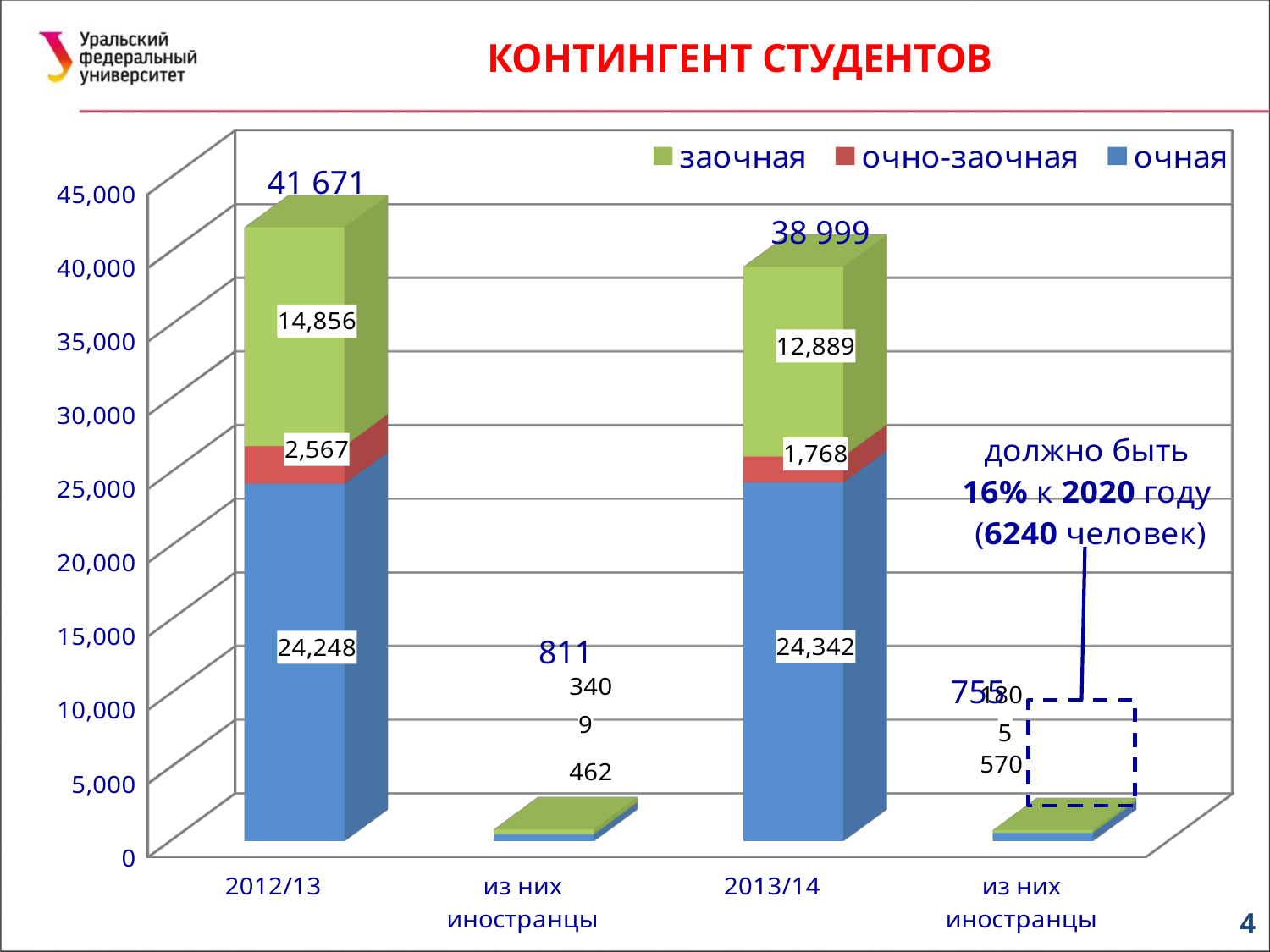
What is the difference between the заочная values for 2012/13 and 2013/14? 1,967 Which is larger, the очная value for 2012/13 or for 2013/14? 2013/14 What is the total shown above the 2013/14 bar? 38 999 How many categories are shown on the x axis? 4 What is the value of the очно-заочная series for 2012/13? 2,567 What is the value of the заочная series for 2013/14? 12,889 What is the title of the chart? КОНТИНГЕНТ СТУДЕНТОВ Which series has the lowest value in the 2013/14 bar? очно-заочная What is the total shown for the foreign students (из них иностранцы) in 2012/13? 811 How many series does the legend list? 3 What is the value of the очная series for 2012/13? 24,248 What kind of chart is shown on the slide? stacked bar chart